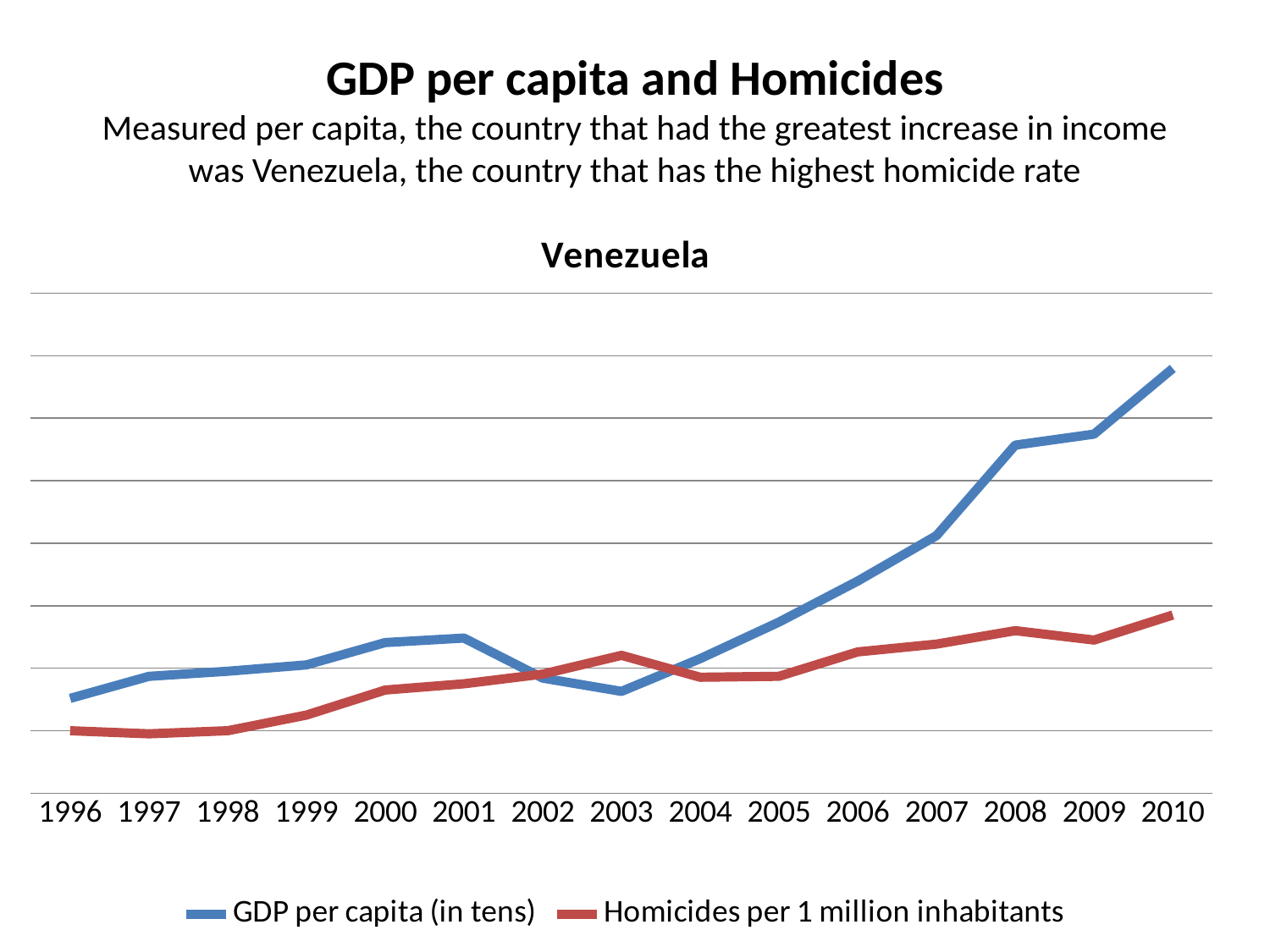
Does GDP per capita (in tens) rise or fall overall from 1996 to 2010? Rise How many years are plotted along the x axis? 15 In which year is Homicides per 1 million inhabitants highest? 2010 What kind of chart is shown on the slide? Line chart Which series is drawn with the blue line? GDP per capita (in tens) Does Homicides per 1 million inhabitants rise or fall overall from 1996 to 2010? Rise In which year is GDP per capita (in tens) highest? 2010 How many series does the legend list? 2 In 2003, which series has the higher value, GDP per capita (in tens) or Homicides per 1 million inhabitants? Homicides per 1 million inhabitants What is the title of the chart? Venezuela In which year is GDP per capita (in tens) lowest? 1996 In 2010, which series has the higher value, GDP per capita (in tens) or Homicides per 1 million inhabitants? GDP per capita (in tens)